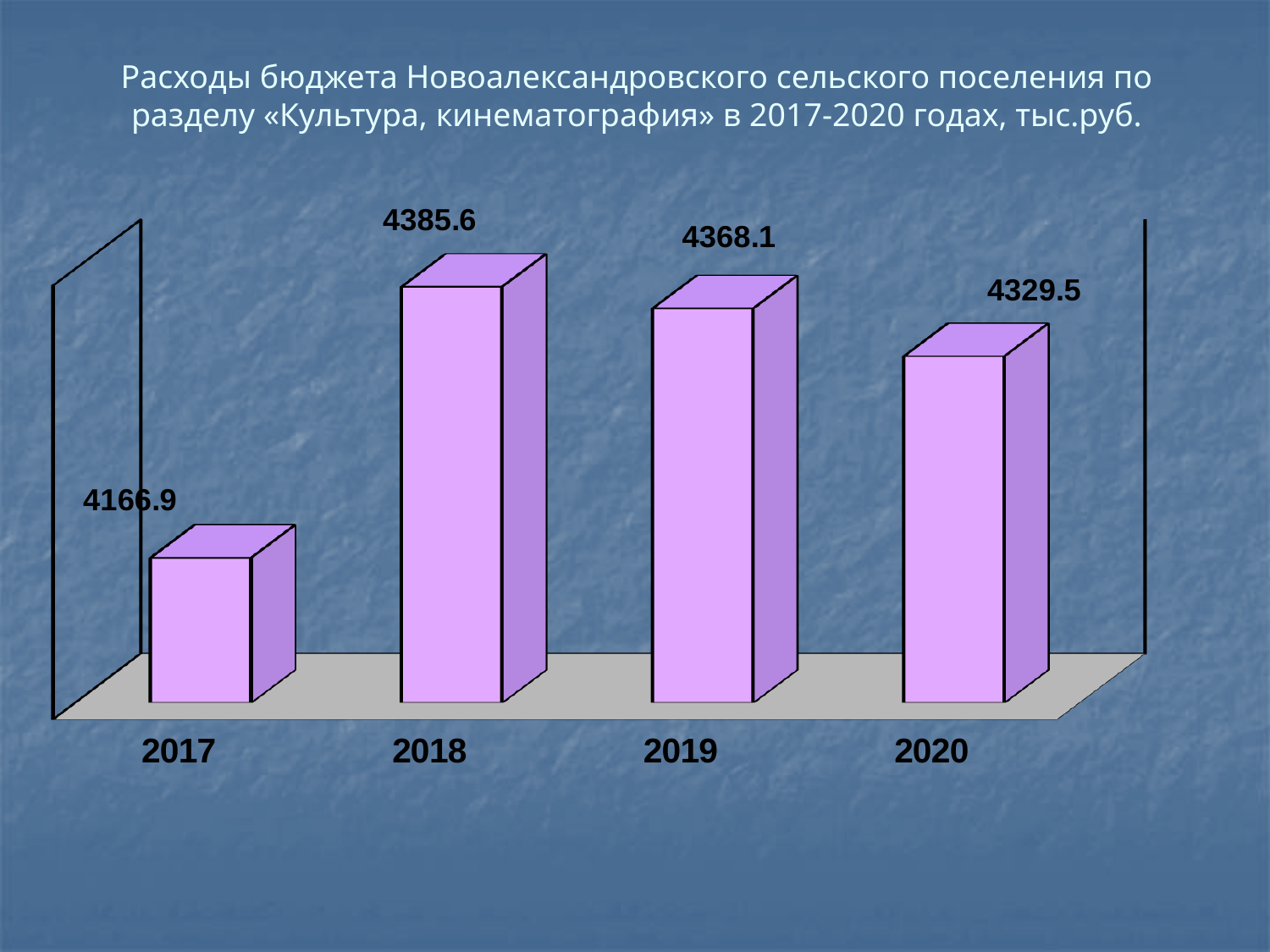
What is the value for 2019? 4368.1 What is the difference between the values for 2018 and 2017? 218.7 In what unit are the values on the chart expressed, according to the title? тыс.руб. What is the value for 2020? 4329.5 What is the value for 2018? 4385.6 How many years are shown on the chart? 4 Which year has the lowest value? 2017 What kind of chart is shown on the slide? bar chart Which year has the highest value? 2018 What is the value for 2017? 4166.9 What is the difference between the values for 2019 and 2020? 38.6 Which is larger, the value for 2018 or the value for 2020? 2018